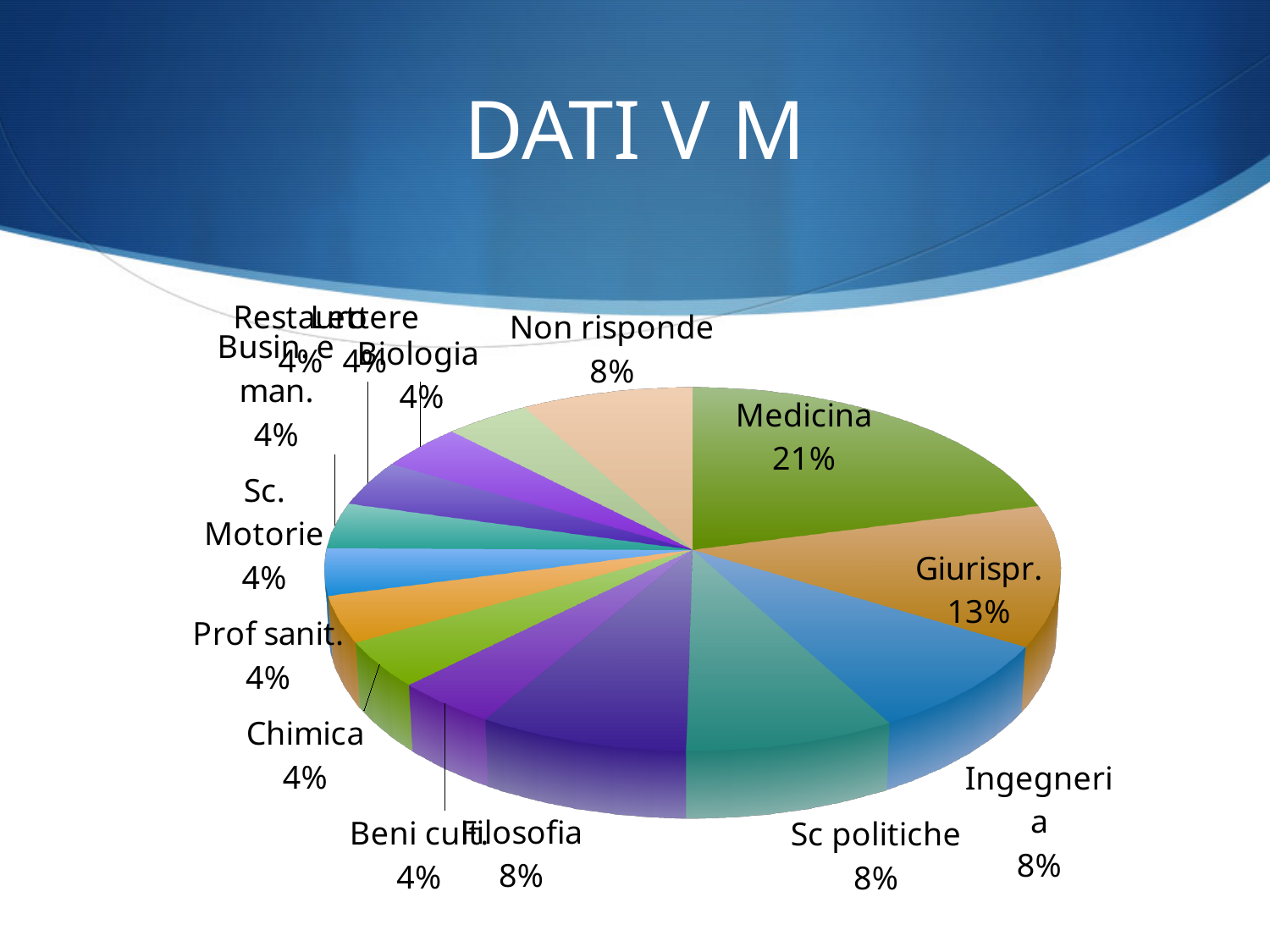
What is the difference in percentage points between Medicina and Giurispr.? 8% What percentage of the pie does Medicina account for? 21% What is the value shown for Sc. Motorie? 4% What is the value shown for Non risponde? 8% What is the value shown for Giurispr.? 13% What is the value shown for Ingegneria? 8% Which is larger, the slice for Giurispr. or the slice for Sc politiche? Giurispr. What is the title of the chart on the slide? DATI V M Which category has the largest slice of the pie? Medicina What is the value shown for Chimica? 4% What kind of chart is shown on the slide? pie chart What is the difference in percentage points between Medicina and Non risponde? 13%